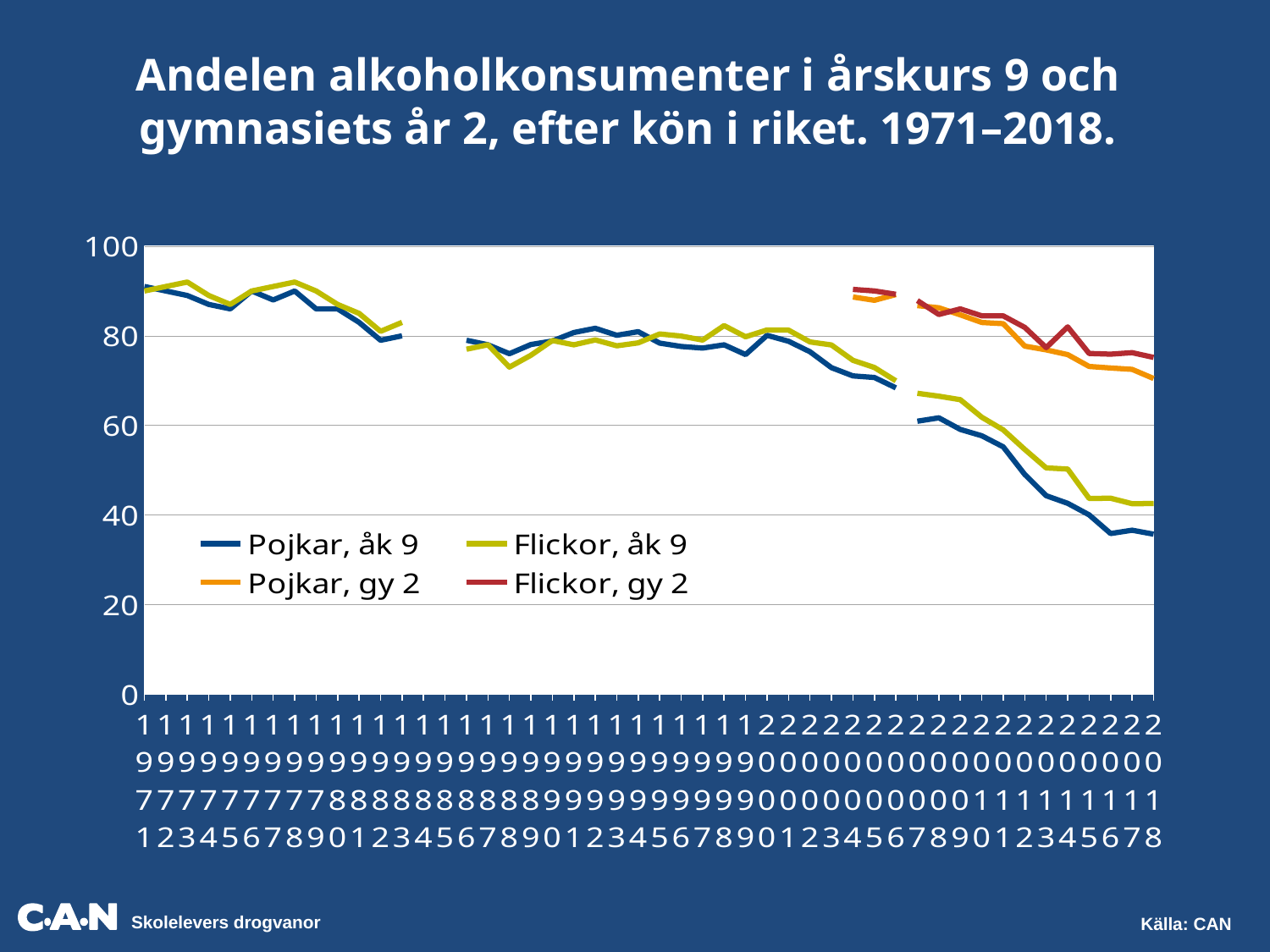
How many series does the legend list? 4 Which series has the highest value in 2018? Flickor, gy 2 Which series has the lowest value in 2018? Pojkar, åk 9 Does the value for Pojkar, åk 9 rise or fall from 1971 to 2018? Fall In 2018, which is larger: Flickor, gy 2 or Pojkar, gy 2? Flickor, gy 2 What kind of chart is shown on the slide? Line chart Is the value for Pojkar, åk 9 in 1971 greater or less than 80? greater What is the title of the chart? Andelen alkoholkonsumenter i årskurs 9 och gymnasiets år 2, efter kön i riket. 1971–2018. Is the value for Flickor, åk 9 in 2018 greater or less than 40? greater Is the value for Flickor, gy 2 in 2018 greater or less than 60? greater Which series is drawn in red? Flickor, gy 2